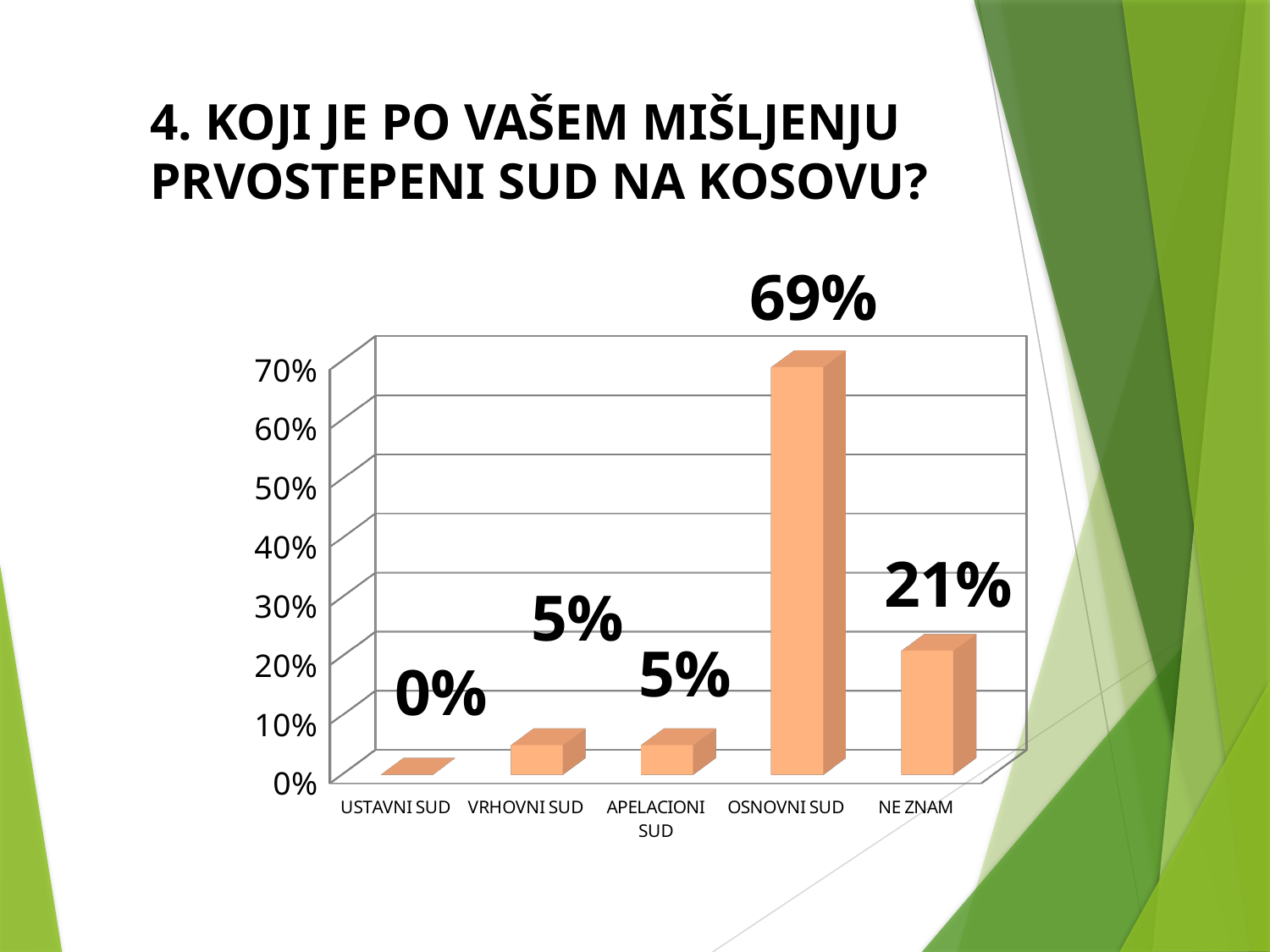
Which category has the lowest value? USTAVNI SUD What kind of chart is shown on the slide? bar chart What is the value for OSNOVNI SUD? 69% What is the difference between the values for OSNOVNI SUD and NE ZNAM? 48% What is the value for NE ZNAM? 21% How many categories are shown on the x axis? 5 What is the title of the slide above the chart? 4. KOJI JE PO VAŠEM MIŠLJENJU PRVOSTEPENI SUD NA KOSOVU? Which is larger, the value for NE ZNAM or the value for APELACIONI SUD? NE ZNAM Which category has the highest value? OSNOVNI SUD What is the value for USTAVNI SUD? 0% What is the value for VRHOVNI SUD? 5% Is the value for OSNOVNI SUD greater or less than 60%? greater